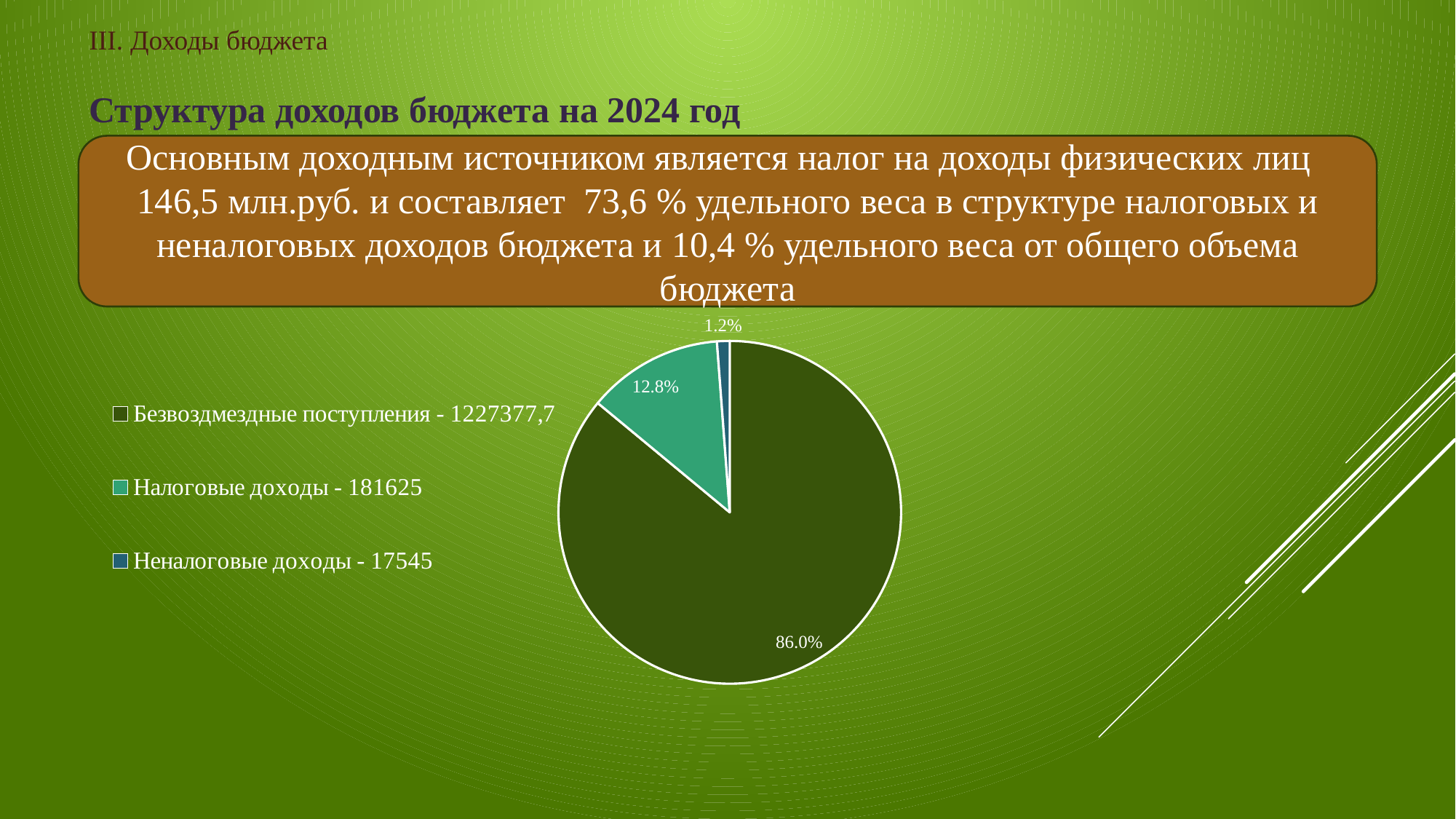
What percentage share does the slice for Безвоздмездные поступления have? 86.0% Which is larger, the share for Налоговые доходы or the share for Неналоговые доходы? Налоговые доходы What is the difference in percentage points between the shares of Налоговые доходы and Неналоговые доходы? 11.6 Which category has the largest slice of the pie? Безвоздмездные поступления What percentage share does the slice for Неналоговые доходы have? 1.2% How many slices does the pie chart have? 3 What value is given in the legend for Безвоздмездные поступления? 1227377,7 What percentage share does the slice for Налоговые доходы have? 12.8% Which category has the smallest slice of the pie? Неналоговые доходы What value is given in the legend for Неналоговые доходы? 17545 What value is given in the legend for Налоговые доходы? 181625 What kind of chart is shown on the slide? pie chart